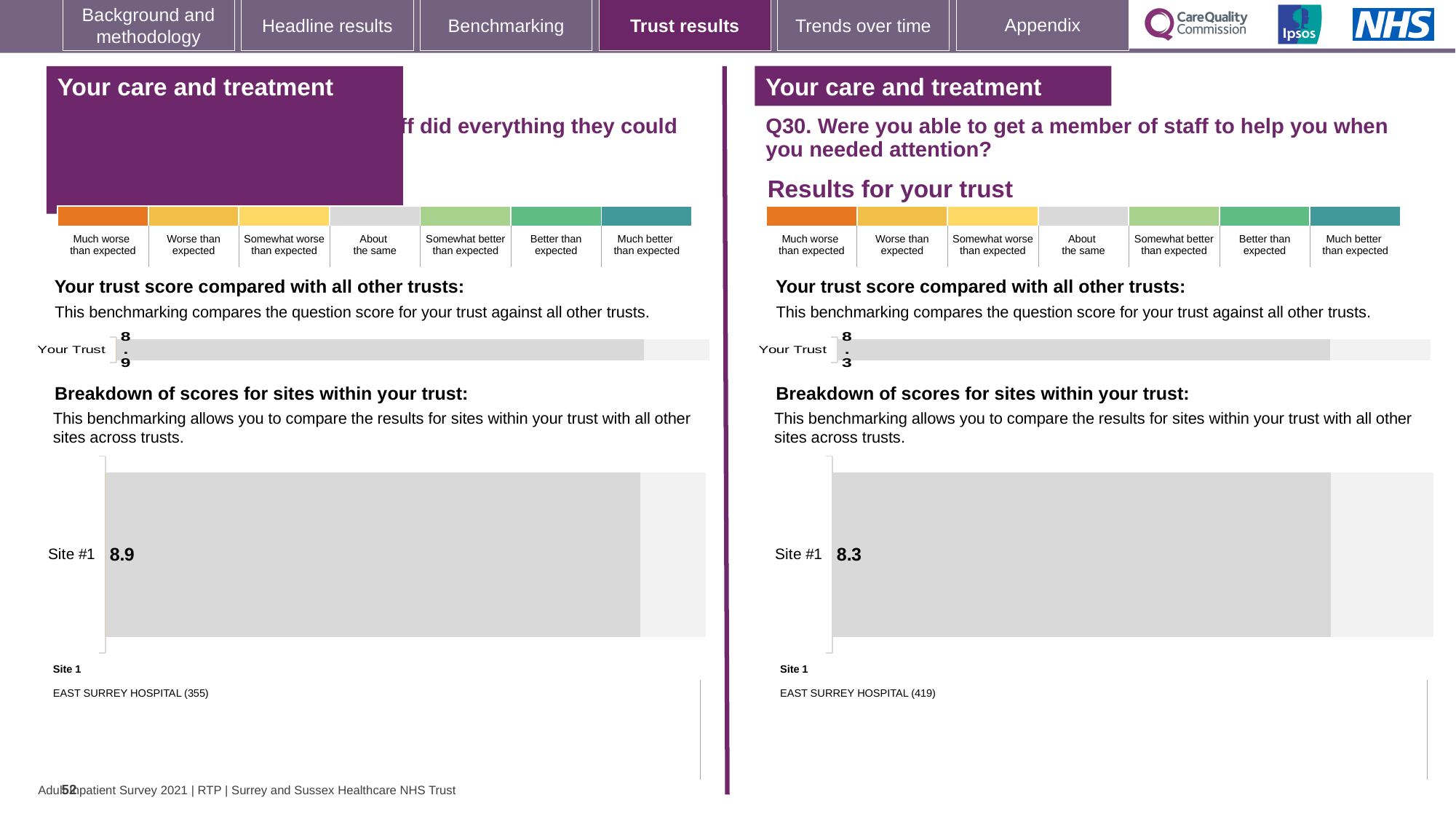
On the right-hand panel (Q30), what is the score shown for Your Trust in the 'Your trust score compared with all other trusts' chart? 8.3 Is the Your Trust score on the right-hand panel (Q30) greater or less than the Your Trust score on the left-hand panel? less On the left-hand panel, what is the score shown for Your Trust in the 'Your trust score compared with all other trusts' chart? 8.9 Which hospital is listed as Site 1 on the left-hand panel? EAST SURREY HOSPITAL (355) What is the difference between the Site #1 score in the left-hand breakdown chart and the Site #1 score in the right-hand breakdown chart? 0.6 Which hospital is listed as Site 1 on the right-hand panel (Q30)? EAST SURREY HOSPITAL (419) What type of chart is used for the 'Breakdown of scores for sites within your trust' on the right-hand panel? Bar chart How many sites are shown in the right-hand 'Breakdown of scores for sites within your trust' chart? 1 In the right-hand 'Breakdown of scores for sites within your trust' chart (Q30), what is the score for Site #1? 8.3 How many sites are shown in the left-hand 'Breakdown of scores for sites within your trust' chart? 1 In the left-hand 'Breakdown of scores for sites within your trust' chart, what is the score for Site #1? 8.9 Which is larger: the Site #1 score in the left-hand breakdown chart or the Site #1 score in the right-hand breakdown chart? Left-hand chart (8.9)